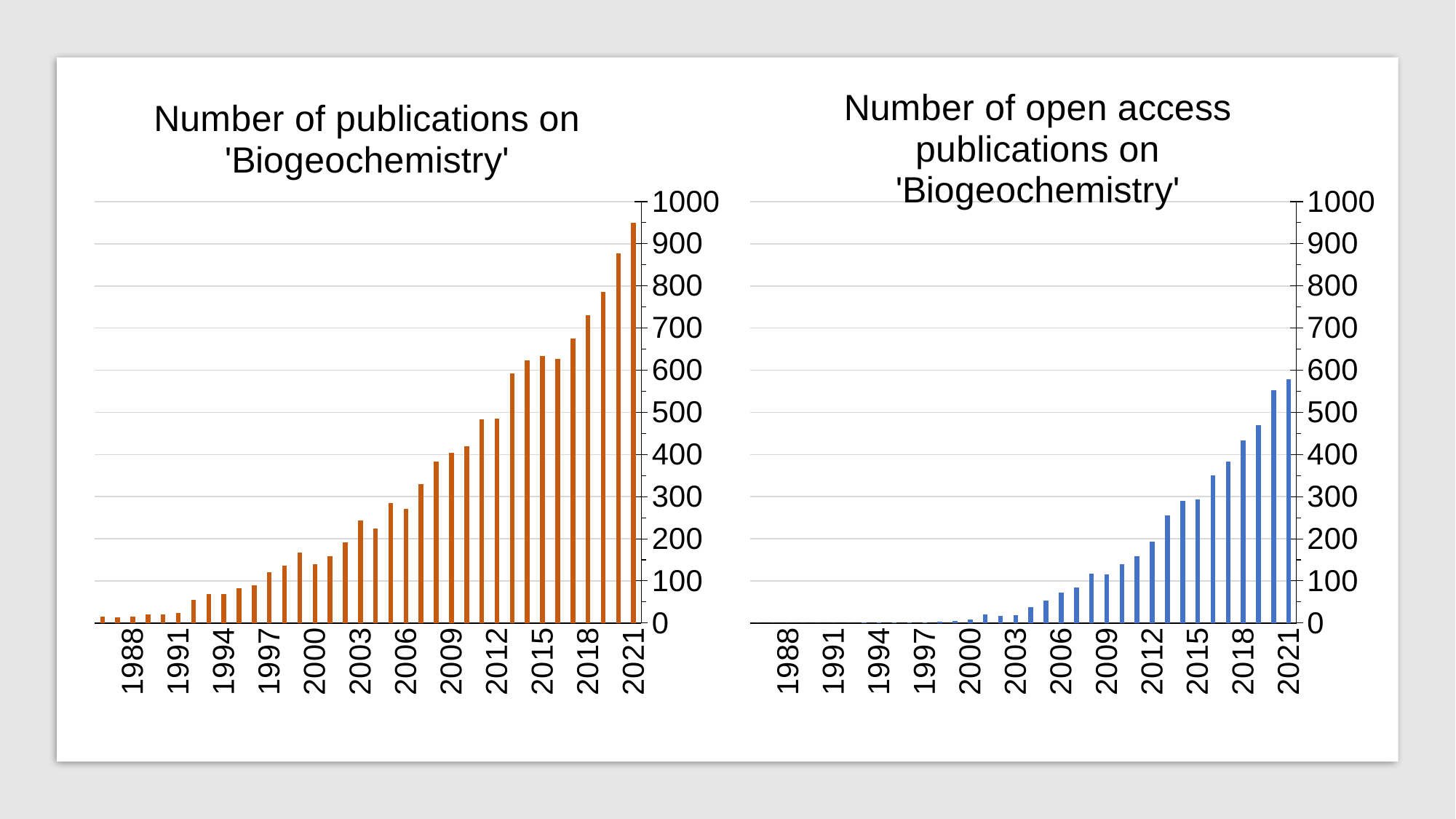
In the left chart, 'Number of publications on Biogeochemistry', is the value for 2021 greater or less than 900? greater What colour are the bars in the right chart, 'Number of open access publications on Biogeochemistry'? blue Which is larger: the 2021 value in the left chart, 'Number of publications on Biogeochemistry', or the 2021 value in the right chart, 'Number of open access publications on Biogeochemistry'? the left chart (Number of publications on Biogeochemistry) In the right chart, 'Number of open access publications on Biogeochemistry', do the values generally rise or fall from 1988 to 2021? rise What kind of chart is the left chart, 'Number of publications on Biogeochemistry'? bar chart In the right chart, 'Number of open access publications on Biogeochemistry', which year has the highest value? 2021 In the right chart, 'Number of open access publications on Biogeochemistry', is the value for 2006 greater or less than 100? less In the right chart, 'Number of open access publications on Biogeochemistry', is the value for 2021 greater or less than 500? greater In the left chart, 'Number of publications on Biogeochemistry', which year has the highest value? 2021